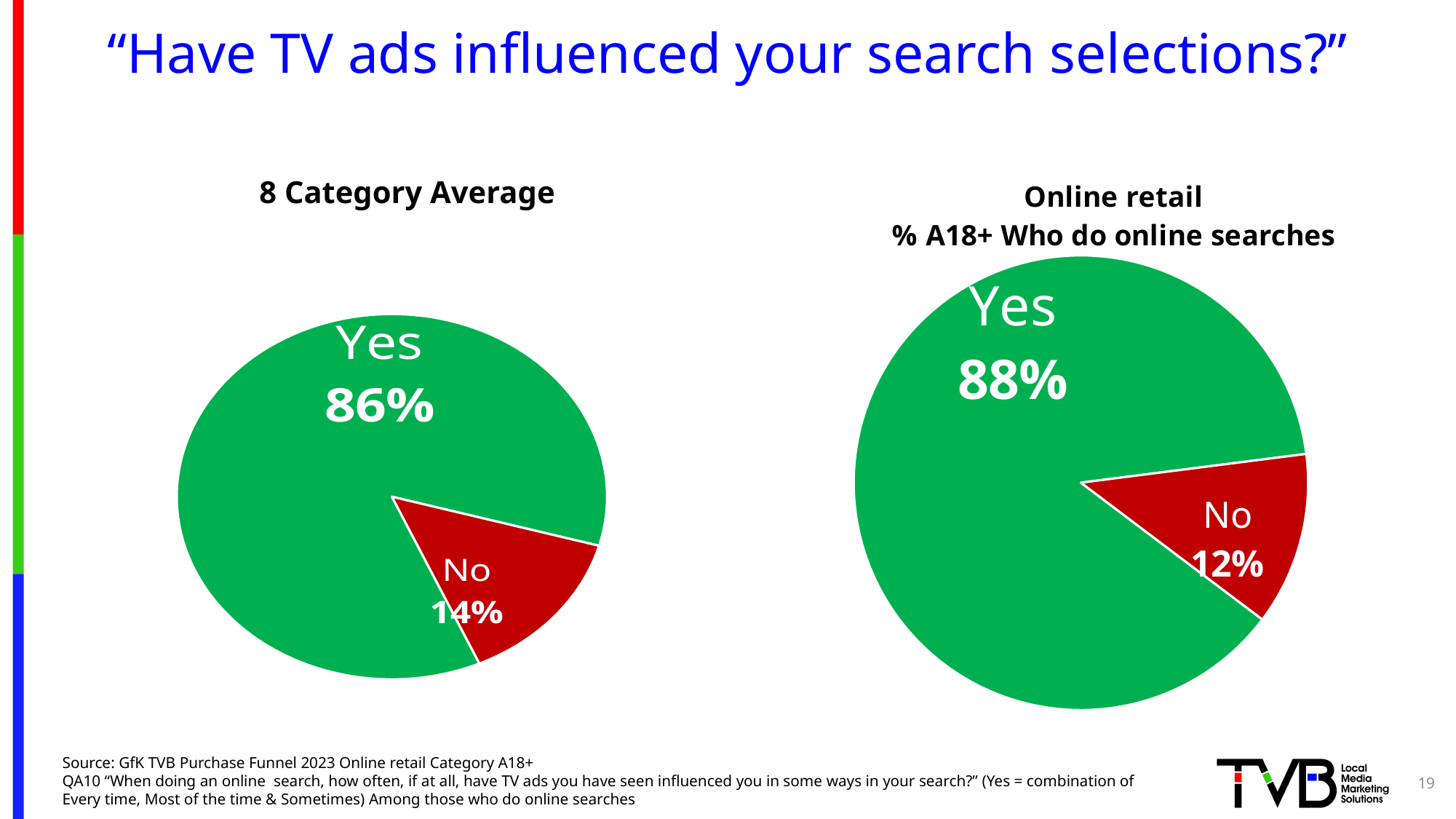
In the '8 Category Average' pie chart, what percentage answered No? 14% What colour is the Yes slice in the 'Online retail' pie chart? Green In the 'Online retail' pie chart, what percentage answered No? 12% In the '8 Category Average' pie chart, what is the difference between the Yes and No percentages? 72% In the 'Online retail' pie chart, what percentage answered Yes? 88% What type of chart is used on the left side of the slide? Pie chart In the '8 Category Average' pie chart, what percentage answered Yes? 86% Which chart has the larger Yes share, '8 Category Average' or 'Online retail'? Online retail How many slices does the 'Online retail' pie chart have? 2 What is the title of the pie chart on the left side of the slide? 8 Category Average In the 'Online retail' pie chart, which slice is the largest? Yes In the '8 Category Average' pie chart, which slice is the smallest? No